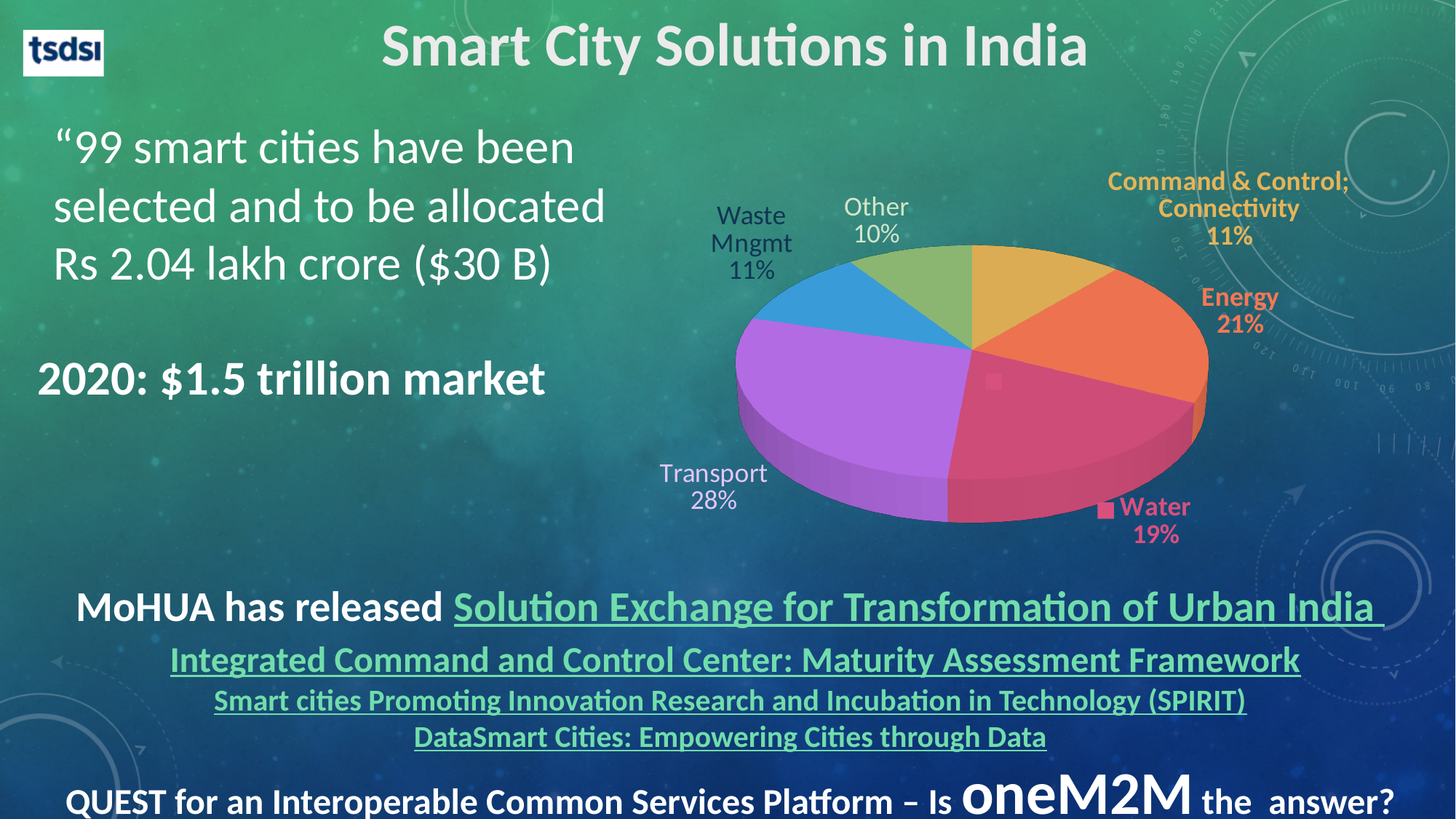
What is the difference in percentage points between Transport and Energy? 7 What is the combined share of Waste Mngmt and Command & Control; Connectivity? 22% What kind of chart is shown on the slide? Pie chart Which category has the largest slice of the pie? Transport What share of the pie does Water have? 19% What colour is the Transport slice of the pie? Purple What share of the pie does Other have? 10% Which category has the smallest slice of the pie? Other Which is larger, the Energy slice or the Water slice? Energy How many categories are shown in the pie chart? 6 What share of the pie does Energy have? 21% What share of the pie does Transport have? 28%